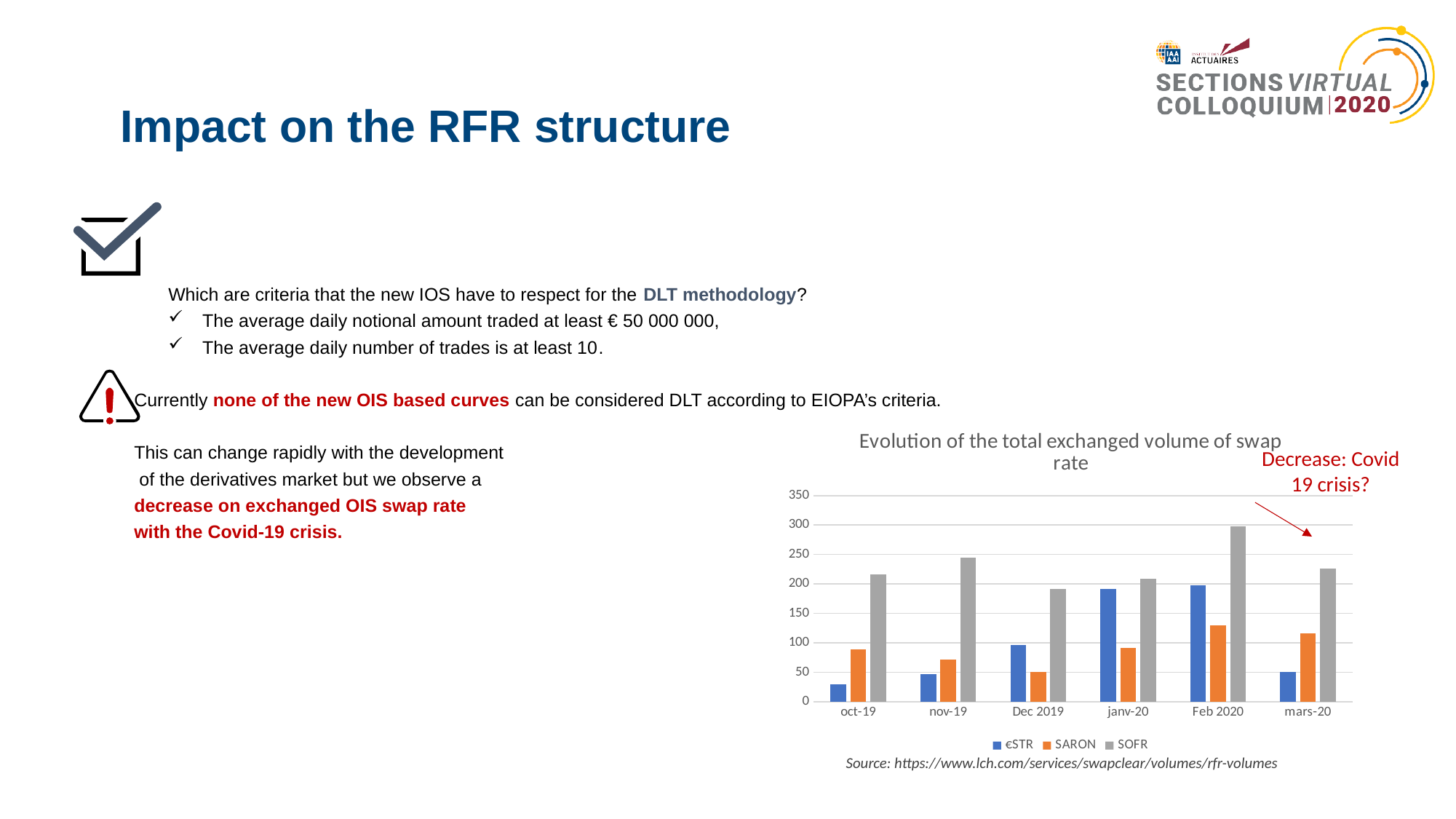
Which series is shown in orange in the chart? SARON How many series does the legend of the chart list? 3 In which month is the SOFR bar highest? Feb 2020 In oct-19, which series has the larger value, SOFR or €STR? SOFR Is the SARON value for Feb 2020 greater or less than 100? greater How many months (categories) are shown on the x axis of the chart? 6 Does the €STR value rise or fall from Feb 2020 to mars-20? Fall Is the €STR value for oct-19 greater or less than 50? less What is the title of the chart? Evolution of the total exchanged volume of swap rate Is the SOFR value for Feb 2020 greater or less than 250? greater What kind of chart is shown on the slide? Bar chart In which month is the €STR bar lowest? oct-19